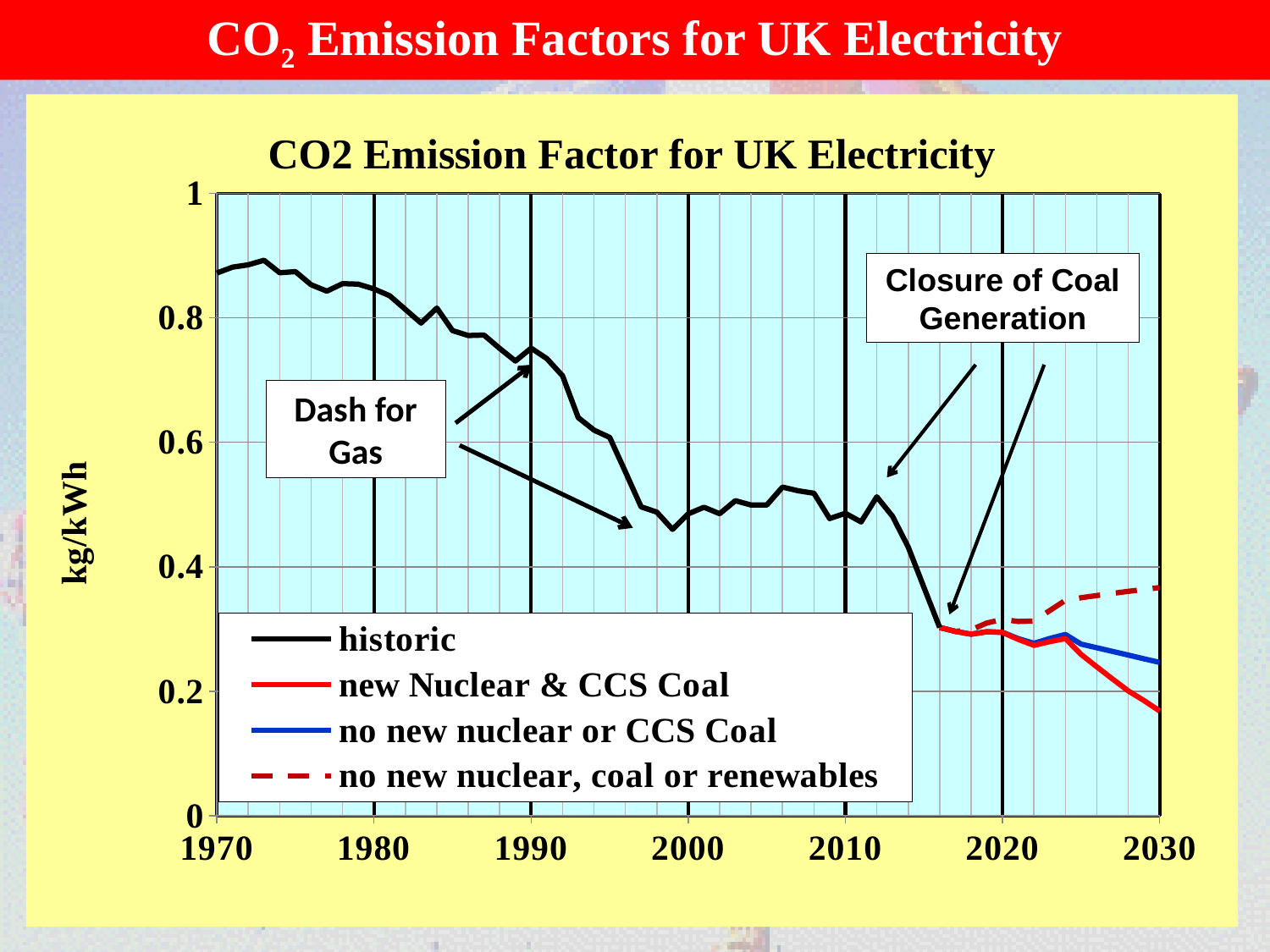
Does the historic line rise or fall between 1970 and 2000? fall What is the title of the chart? CO2 Emission Factor for UK Electricity Is the 2030 value for 'new Nuclear & CCS Coal' greater or less than 0.2? less Which series has the lowest value in 2030? new Nuclear & CCS Coal Is the historic value in 1970 greater or less than 0.8? greater What kind of chart is shown on the slide? line chart How many series does the legend list? 4 What is the y-axis label of the chart? kg/kWh Is the historic value in 2010 greater or less than 0.4? greater Which series has the highest value in 2030? no new nuclear, coal or renewables